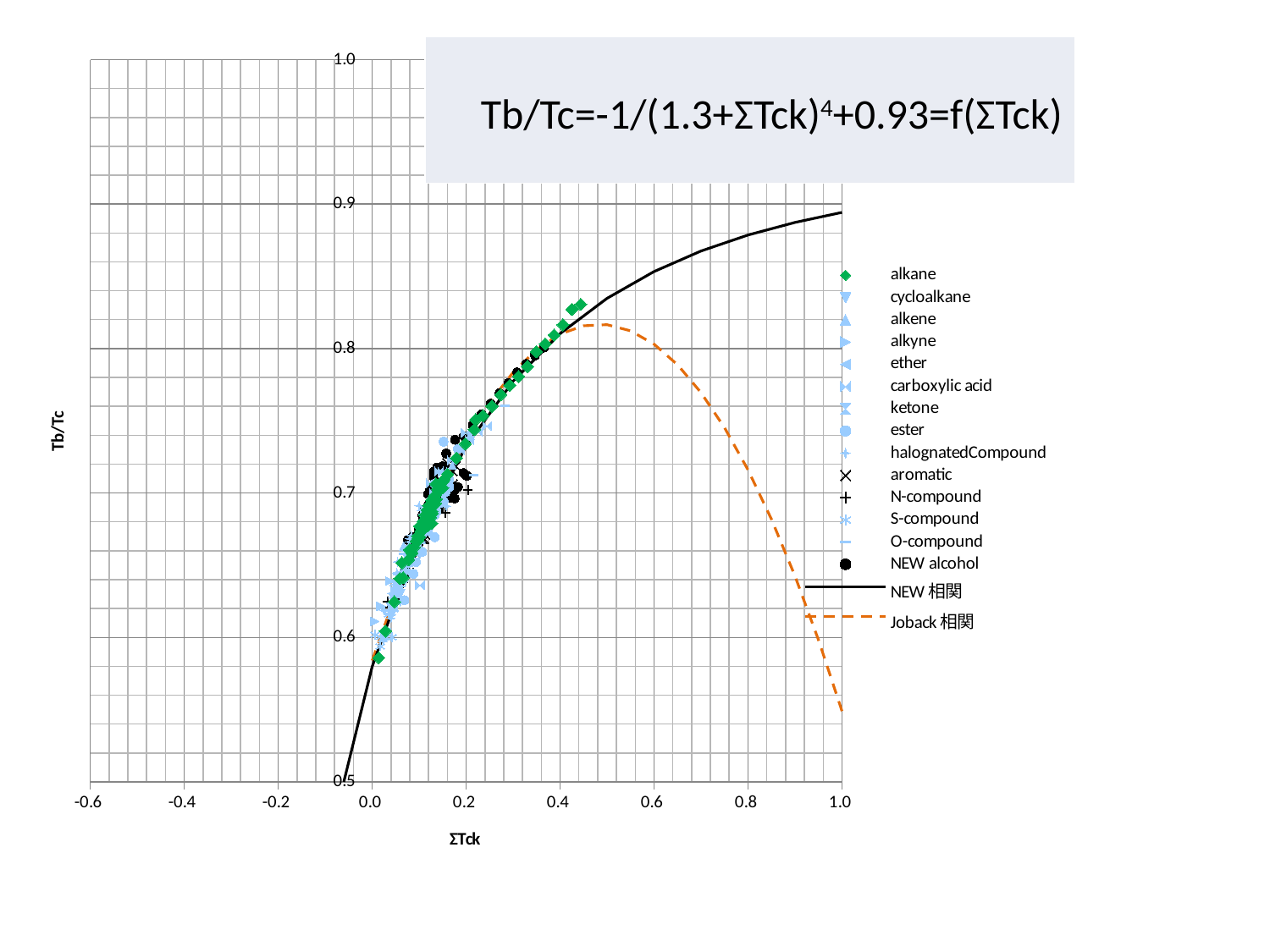
What is the label of the x axis? ΣTck What is the maximum value shown on the x axis? 1.0 Does the NEW 相関 line rise or fall as ΣTck increases from 0.0 to 1.0? rise How many entries does the chart legend list? 16 At ΣTck = 1.0, is the value of the NEW 相関 line greater or less than 0.9? less At ΣTck = 1.0, which line has the higher Tb/Tc value, NEW 相関 or Joback 相関? NEW 相関 At ΣTck = 1.0, is the value of the Joback 相関 line greater or less than 0.6? less Is the peak value of the Joback 相関 line greater or less than 0.8? greater What kind of chart is shown on the slide? scatter chart What is the minimum value shown on the y axis? 0.5 Does the Joback 相関 line rise or fall as ΣTck increases from 0.6 to 1.0? fall